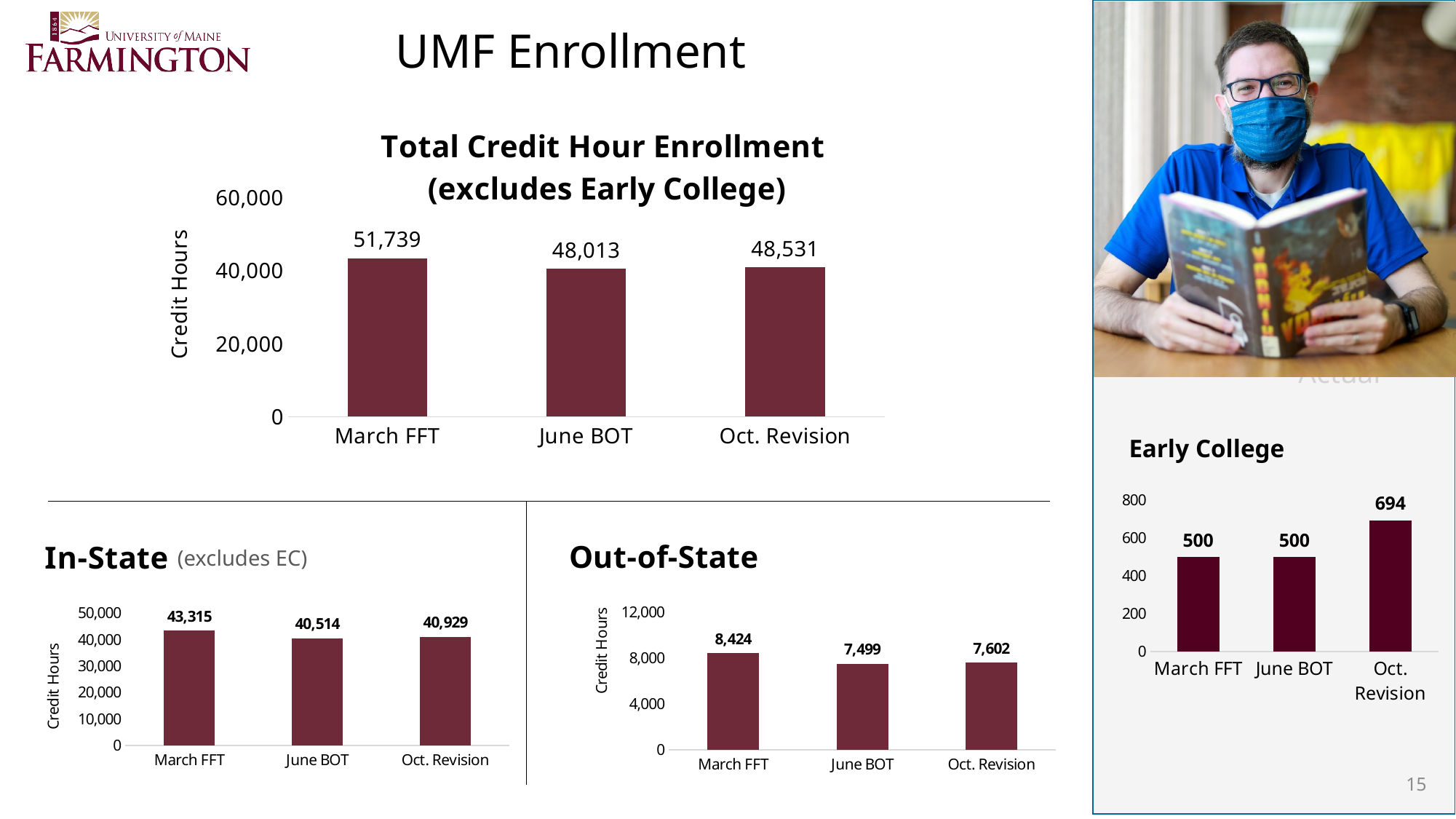
In the In-State chart, what is the value for Oct. Revision? 40,929 In the Out-of-State chart, what is the difference between March FFT and Oct. Revision? 822 In the Total Credit Hour Enrollment chart, what is the difference between March FFT and June BOT? 3,726 In the Early College chart, what is the value for Oct. Revision? 694 In the Out-of-State chart, is the value for March FFT larger or smaller than the value for Oct. Revision? larger In the Out-of-State chart, what is the value for June BOT? 7,499 In the Total Credit Hour Enrollment chart, which category has the lowest value? June BOT In the Total Credit Hour Enrollment chart, what is the value for March FFT? 51,739 In the In-State chart, what is the difference between Oct. Revision and June BOT? 415 In the Early College chart, how many categories are shown on the x axis? 3 In the In-State chart, which category has the highest value? March FFT What kind of chart is the Early College chart? bar chart